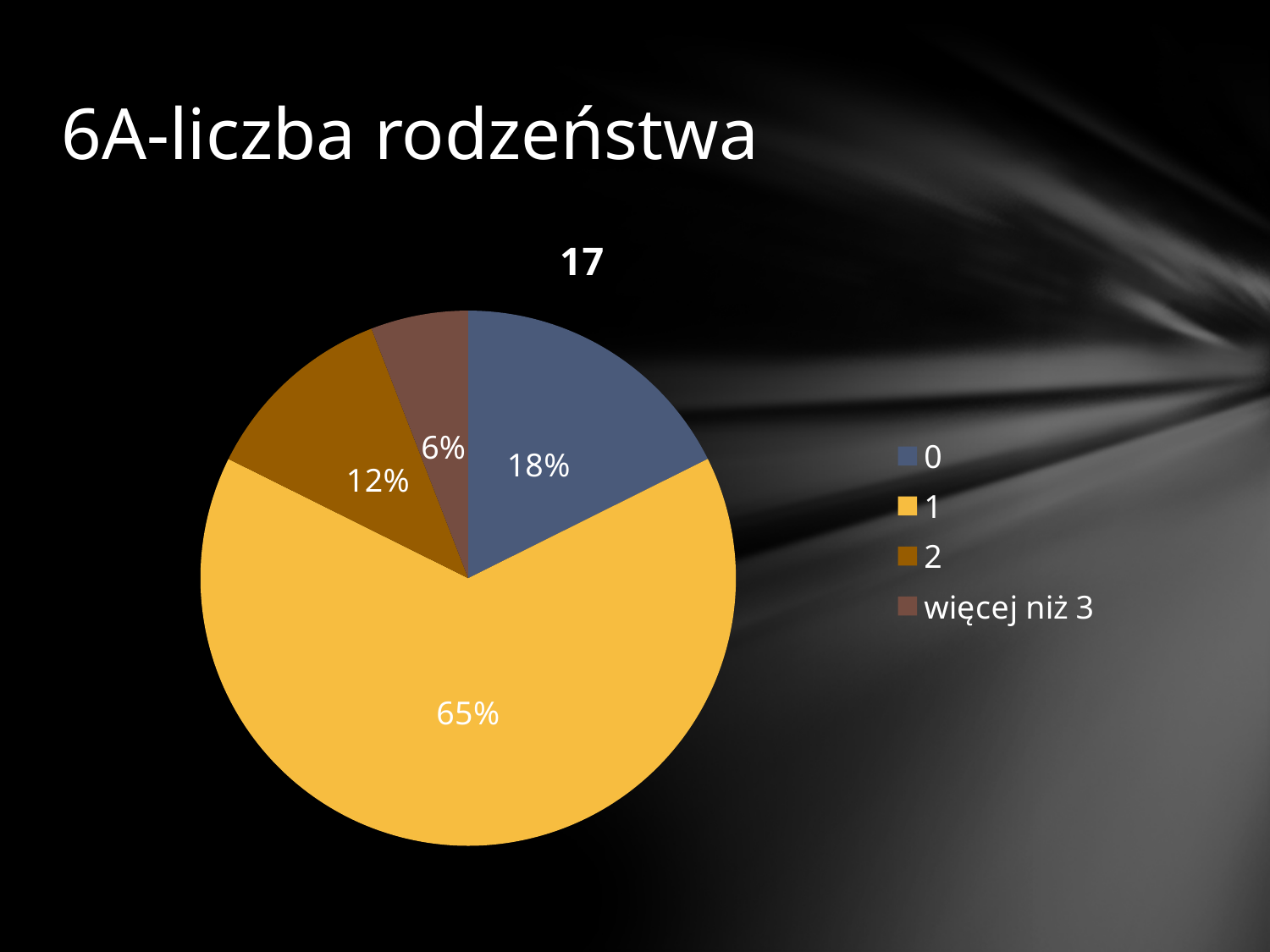
Which slice is larger, "0" or "2"? 0 How many categories does the pie chart have? 4 What is the difference in percentage points between the slices for "1" and "0"? 47 Which category has the largest slice of the pie? 1 What colour is the slice for the category "1"? yellow What share of the pie does the category "0" take? 18% What is the title shown above the pie chart? 17 What share of the pie does the category "1" take? 65% What kind of chart is shown on the slide? pie chart Which category has the smallest slice of the pie? więcej niż 3 What share of the pie does the category "więcej niż 3" take? 6%